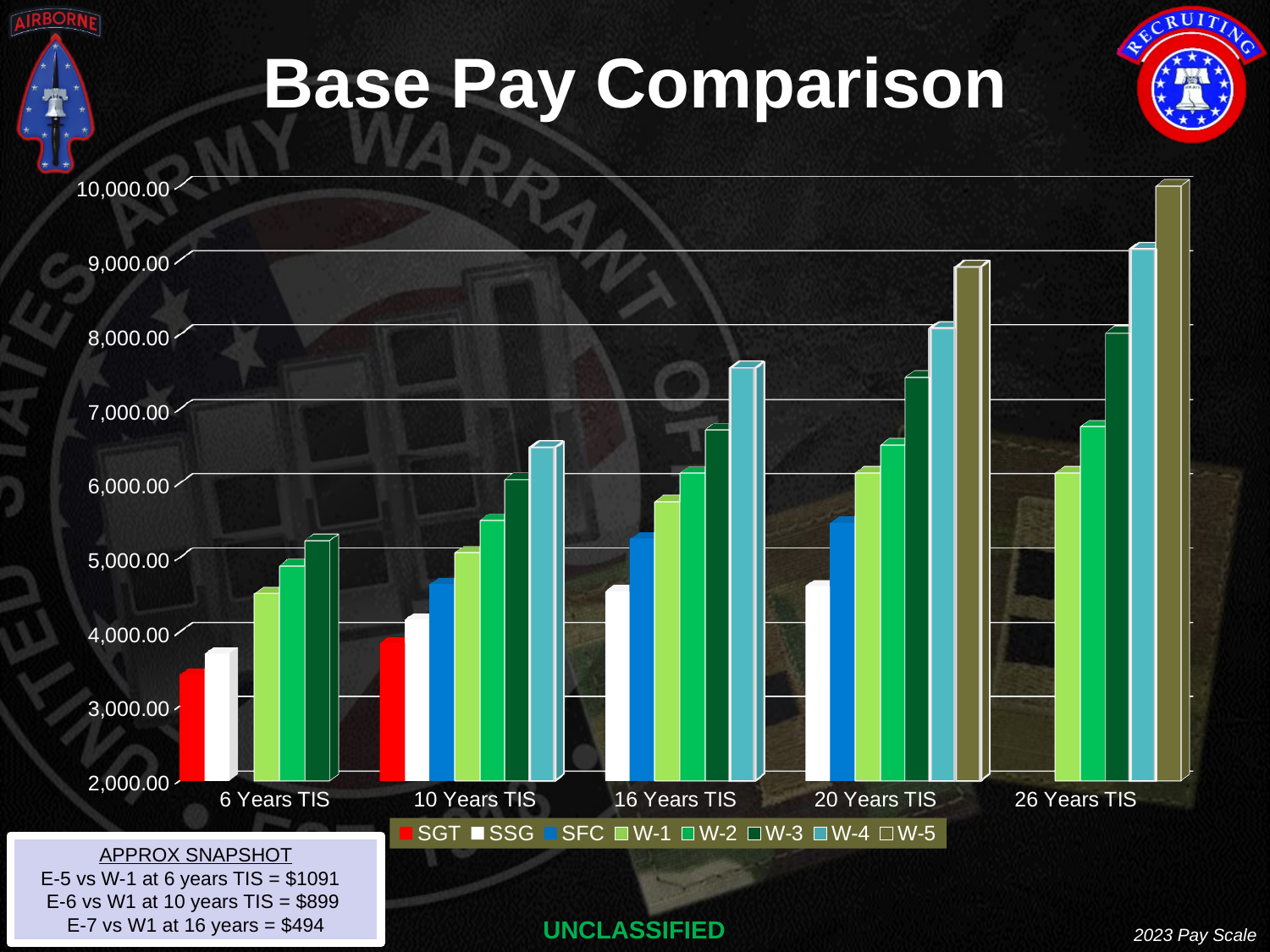
At 16 Years TIS, which is larger: the W-4 bar or the W-3 bar? W-4 Do the W-1 values rise or fall as years of TIS increase along the x axis? Rise How many time-in-service categories are shown on the x axis? 5 What kind of chart is shown on the slide? Bar chart Is the value for SGT at 6 Years TIS greater or less than 4,000.00? less Which series has the shortest bar on the chart, and in which category? SGT at 6 Years TIS Is the value for W-4 at 16 Years TIS greater or less than 7,000.00? greater Is the value for W-4 at 10 Years TIS greater or less than 6,000.00? greater What is the title of the chart? Base Pay Comparison Which series has the tallest bar on the chart, and in which category? W-5 at 26 Years TIS How many series does the chart legend list? 8